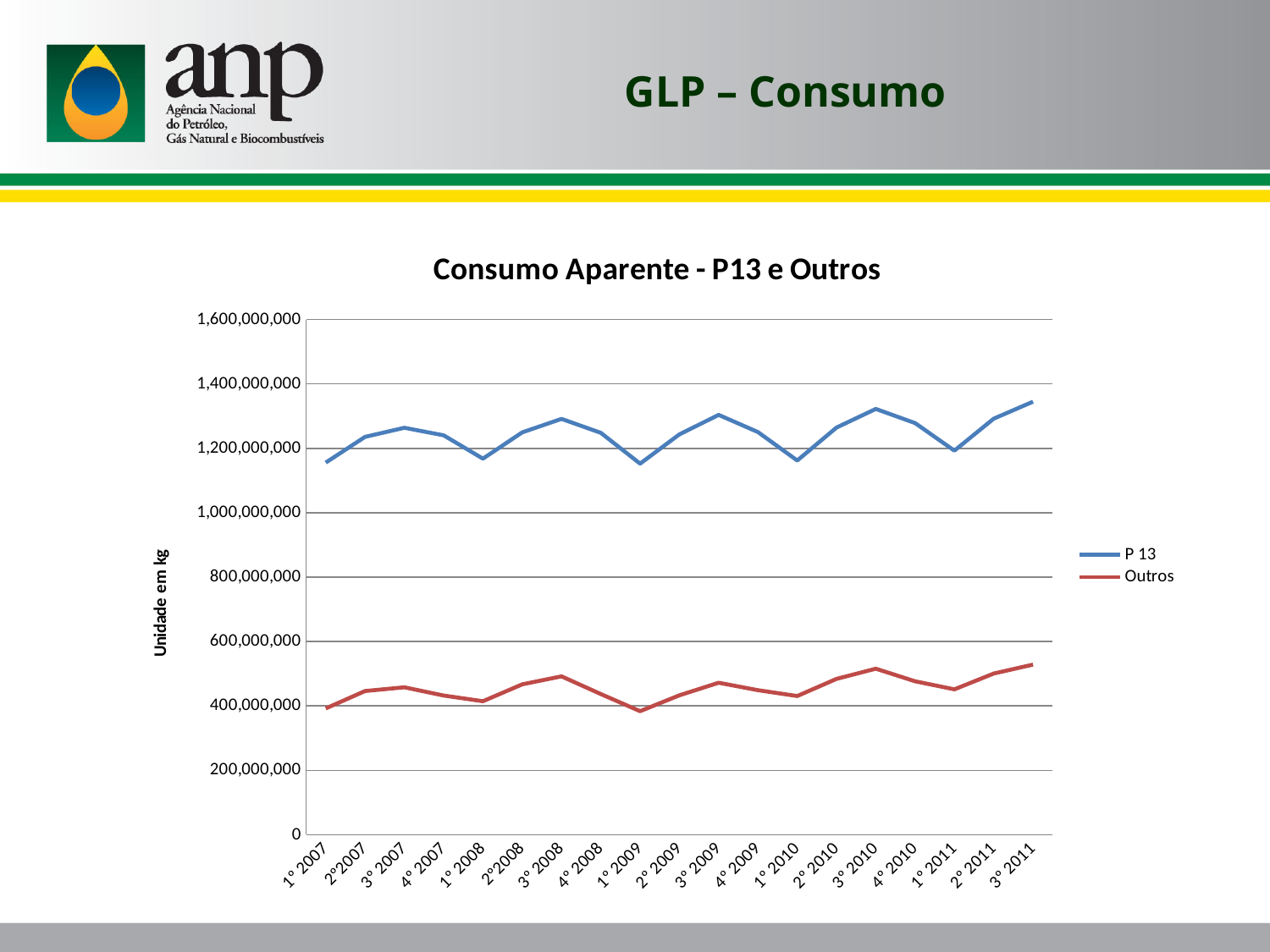
What kind of chart is shown on the slide? line chart Is the value for P 13 in 1° 2007 greater or less than 1,000,000,000? greater Is the value for Outros in 3° 2011 greater or less than 600,000,000? less Which series has the larger value in 2° 2010, P 13 or Outros? P 13 How many quarters are plotted along the x axis? 19 How many series does the legend list? 2 Is the value for P 13 in 3° 2011 greater or less than 1,200,000,000? greater For P 13, which is larger: the value in 3° 2008 or the value in 1° 2009? 3° 2008 Does the Outros line end higher or lower in 3° 2011 than it starts in 1° 2007? higher What is the label of the vertical axis? Unidade em kg What is the title of the chart? Consumo Aparente - P13 e Outros